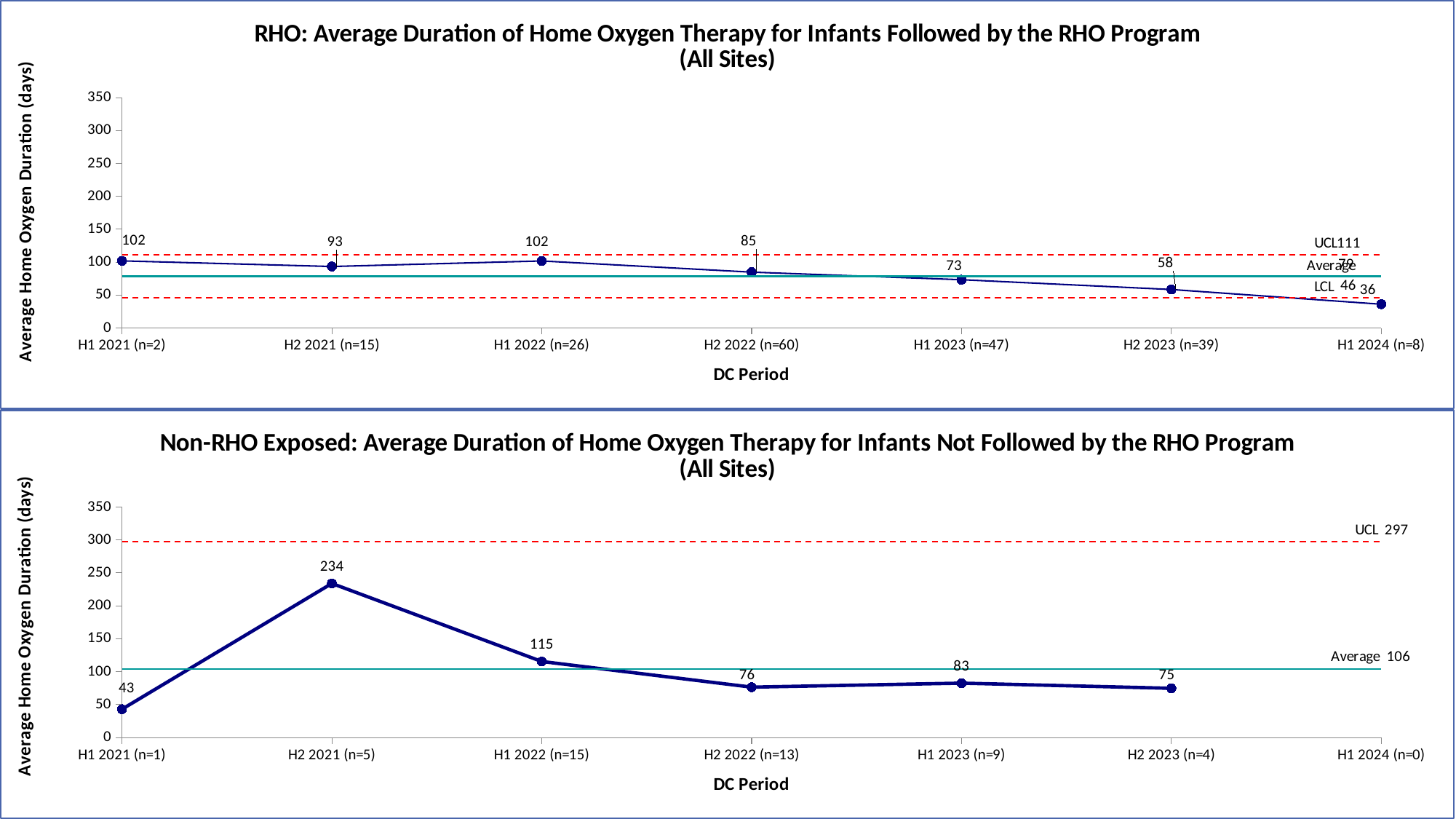
In the bottom chart (Non-RHO Exposed), which is larger, the value for H1 2023 (n=9) or the value for H2 2023 (n=4)? H1 2023 (n=9) What kind of chart is the bottom chart (Non-RHO Exposed)? line chart In the top chart (RHO), what is the UCL value shown? 111 In the top chart (RHO), do the values generally rise or fall from H2 2022 to H1 2024? fall In the bottom chart (Non-RHO Exposed), what is the value for H2 2021 (n=5)? 234 In the top chart (RHO), what is the value for H1 2024 (n=8)? 36 In the bottom chart (Non-RHO Exposed), which DC period has the highest average home oxygen duration? H2 2021 (n=5) In the top chart (RHO), what is the average home oxygen duration for H2 2023 (n=39)? 58 In the bottom chart (Non-RHO Exposed), what is the difference between the H2 2021 value and the H1 2022 value? 119 In the top chart (RHO), what is the difference between the H2 2022 value and the H1 2023 value? 12 In the top chart (RHO), which DC period has the lowest average home oxygen duration? H1 2024 (n=8) In the bottom chart (Non-RHO Exposed), which DC period has the lowest plotted value? H1 2021 (n=1)